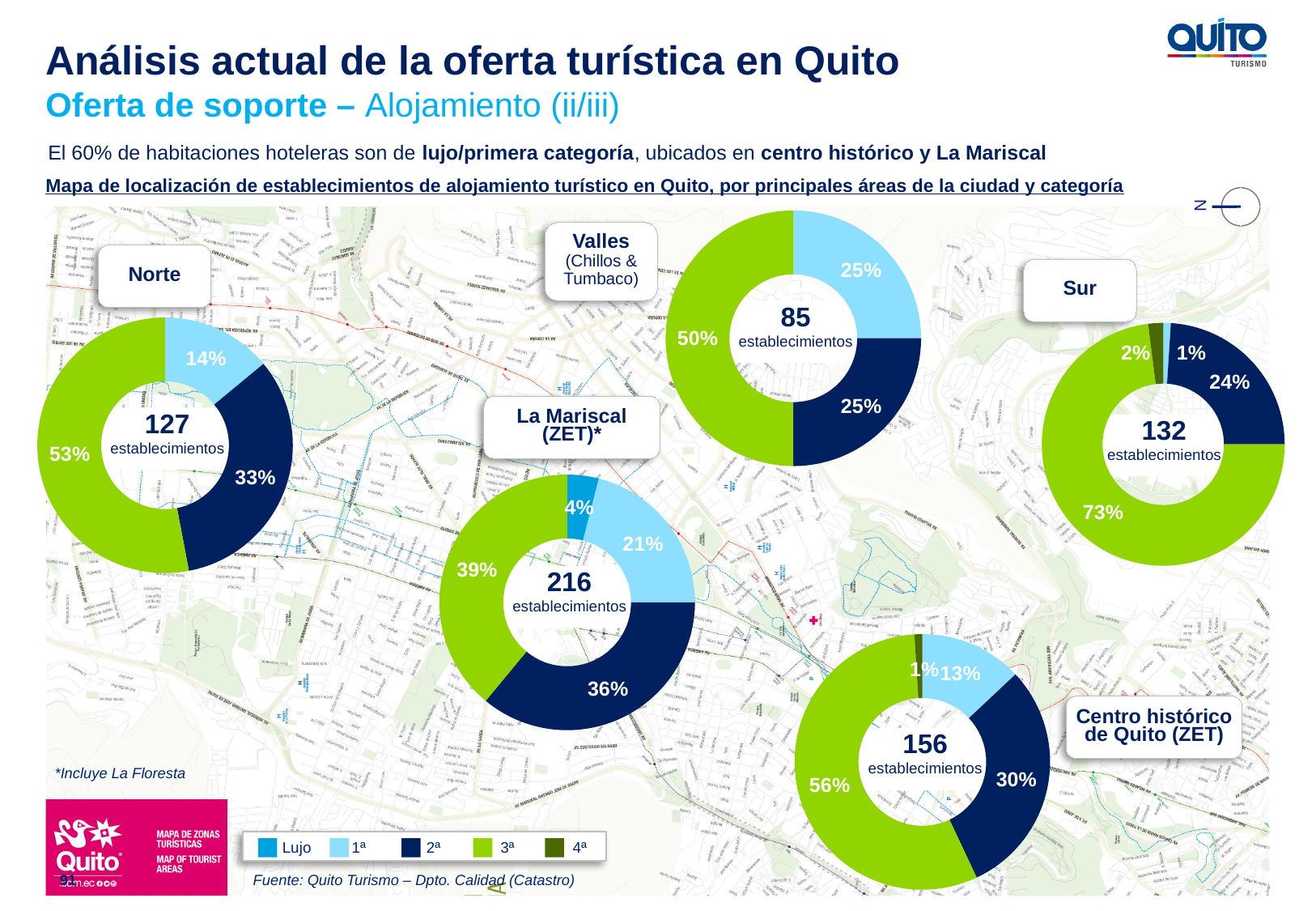
Which area's chart shows more establecimientos in its centre: La Mariscal (ZET) or Sur? La Mariscal (ZET) In the Sur donut chart, which category has the smallest share? 1ª In the Centro histórico de Quito (ZET) donut chart, what is the difference between the 3ª share and the 2ª share? 26% In the Norte donut chart, how many establecimientos are shown in the centre? 127 In the Valles (Chillos & Tumbaco) donut chart, how many establecimientos are shown in the centre? 85 How many donut charts are shown on the map? 5 In the La Mariscal (ZET) donut chart, which category has the largest share? 3ª How many categories does the legend at the bottom of the slide list? 5 In the La Mariscal (ZET) donut chart, what share is labelled for the Lujo category? 4% In the Sur donut chart, what share is labelled for the 2ª category (dark blue slice)? 24% What kind of chart is used for each area on the map? Donut (pie) chart In the Norte donut chart, what share is labelled for the 3ª category (green slice)? 53%